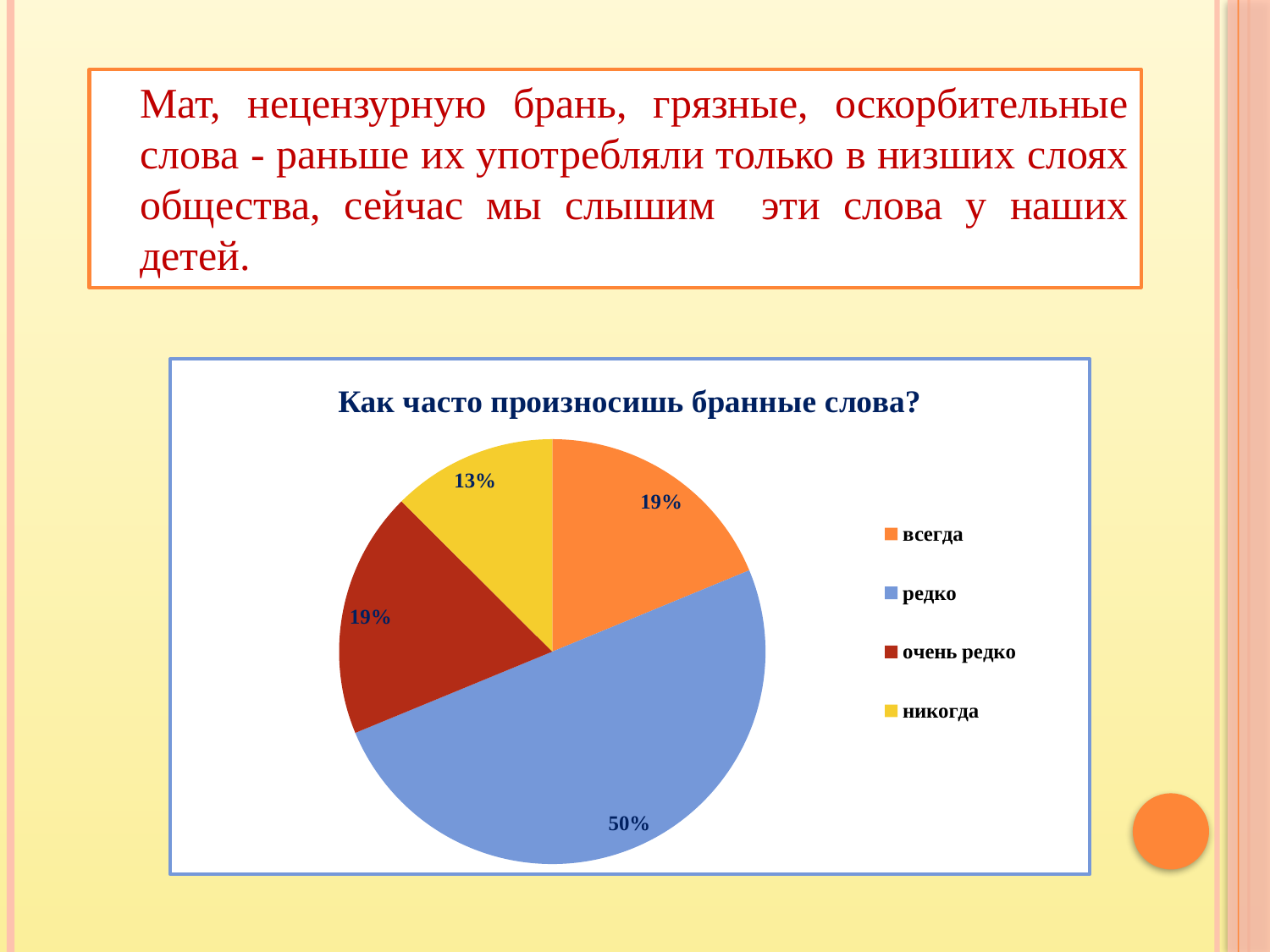
What share of the pie is labelled "редко"? 50% What is the title of the chart? Как часто произносишь бранные слова? Which is larger, the share for "редко" or the share for "всегда"? редко What kind of chart is shown on the slide? pie chart What is the difference between the shares for "редко" and "никогда"? 37% Which category has the largest share of the pie? редко What is the value for "очень редко"? 19% How many categories does the pie chart have? 4 What is the value for "никогда"? 13% Which colour represents "никогда" in the legend? yellow Which category has the smallest share of the pie? никогда What is the value for "всегда"? 19%